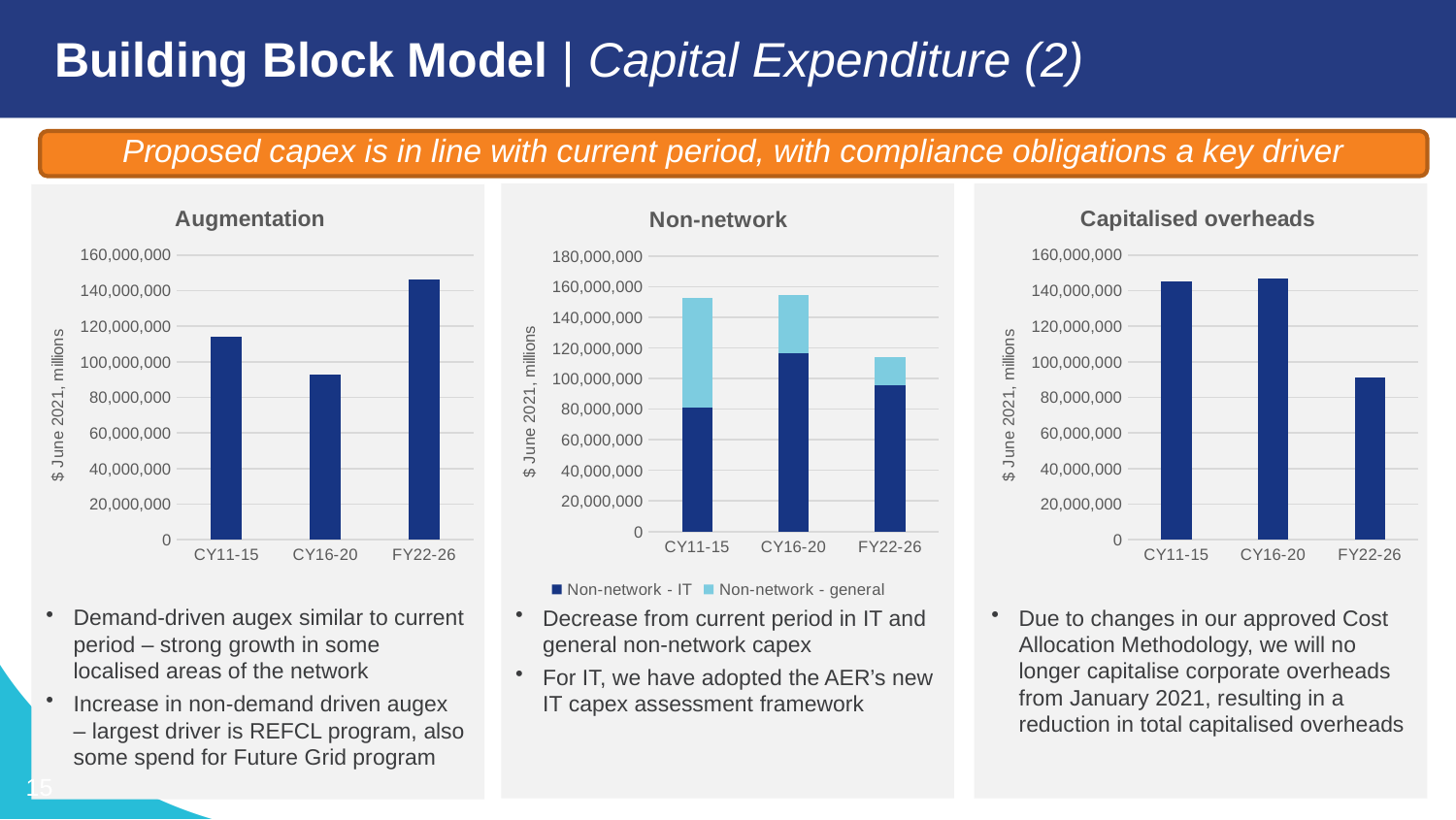
In the Non-network chart, is the Non-network - IT value for CY11-15 greater or less than 100,000,000? less In the Augmentation chart, is the value for CY16-20 greater or less than 100,000,000? less In the Capitalised overheads chart, which period has the lowest value? FY22-26 In the Augmentation chart, which period has the highest value? FY22-26 How many periods are shown on the x axis of the Non-network chart? 3 In the Non-network chart, which period has the highest Non-network - IT value? CY16-20 In the Capitalised overheads chart, is the value for CY11-15 greater or less than 140,000,000? greater What type of chart is the Augmentation chart? bar chart How many series does the legend of the Non-network chart list? 2 In the Augmentation chart, which period has the lowest value? CY16-20 In the Non-network chart, which period has the lowest total stacked bar? FY22-26